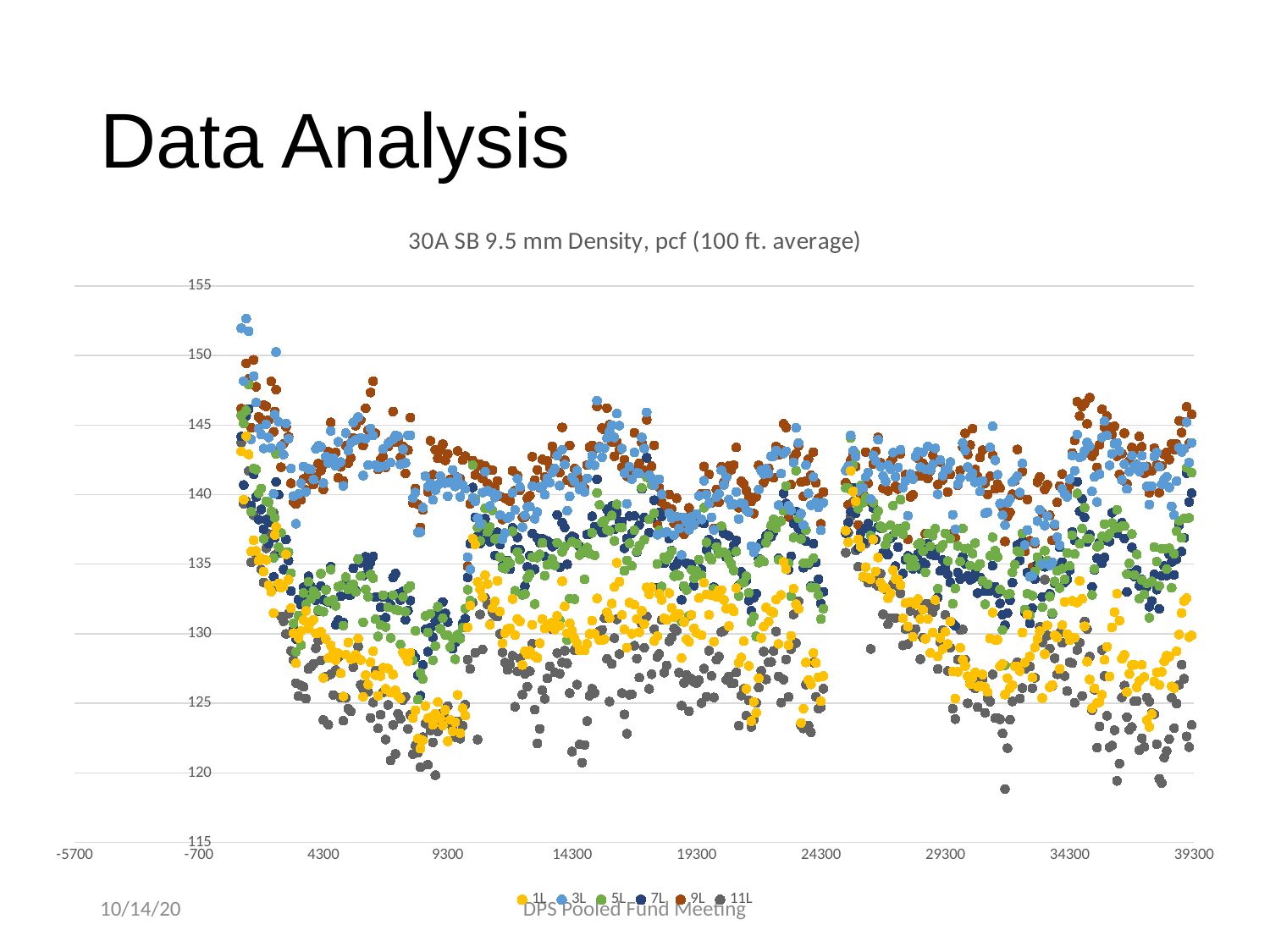
Are the values for series 9L mostly greater or less than 135? greater What is the title of the chart? 30A SB 9.5 mm Density, pcf (100 ft. average) Is the highest plotted point in the chart greater or less than 150? greater Which series generally has higher values, 9L or 1L? 9L Is the lowest plotted point in the chart greater or less than 120? less How many series does the chart's legend list? 6 Which series has the lowest density values overall in the chart? 11L What kind of chart is shown on the slide? scatter chart Which series generally has higher values, 11L or 3L? 3L What is the highest value shown on the chart's vertical axis? 155 Which series are listed in the chart's legend? 1L, 3L, 5L, 7L, 9L, 11L